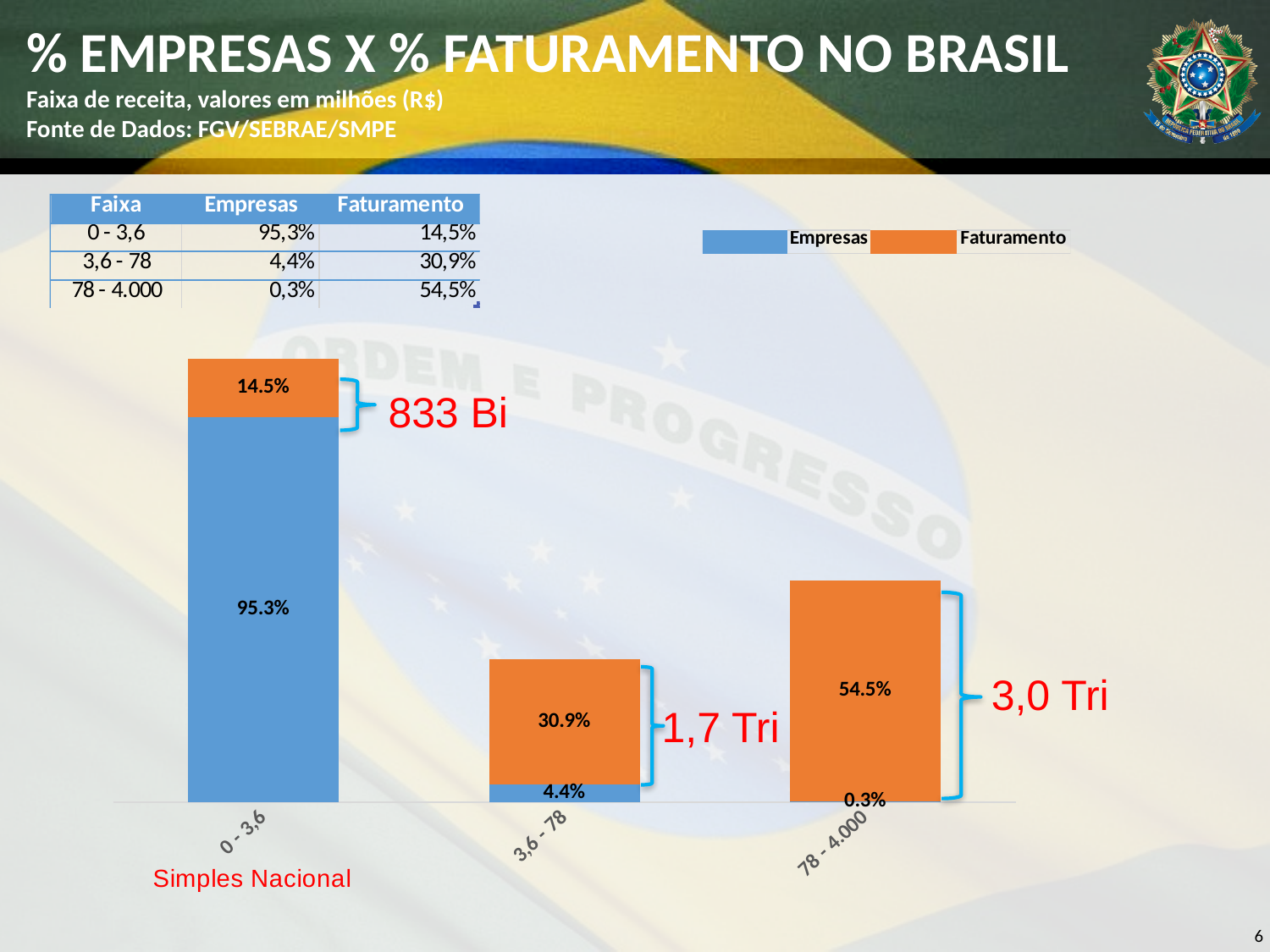
What is the difference between the Empresas value and the Faturamento value for the "0 - 3,6" category? 80.8% Which category has the highest Faturamento value? 78 - 4.000 What is the Faturamento value for the "3,6 - 78" category? 30.9% What is the Empresas value for the "78 - 4.000" category? 0.3% How many categories are shown on the x axis of the chart? 3 What kind of chart is shown on the slide? Stacked bar chart Which colour represents the Faturamento series in the chart? Orange Which category has the lowest Empresas value? 78 - 4.000 How many series does the chart legend list? 2 What is the Empresas value for the "0 - 3,6" category? 95.3% What is the Faturamento value for the "78 - 4.000" category? 54.5% Which is larger for the "3,6 - 78" category: Empresas or Faturamento? Faturamento